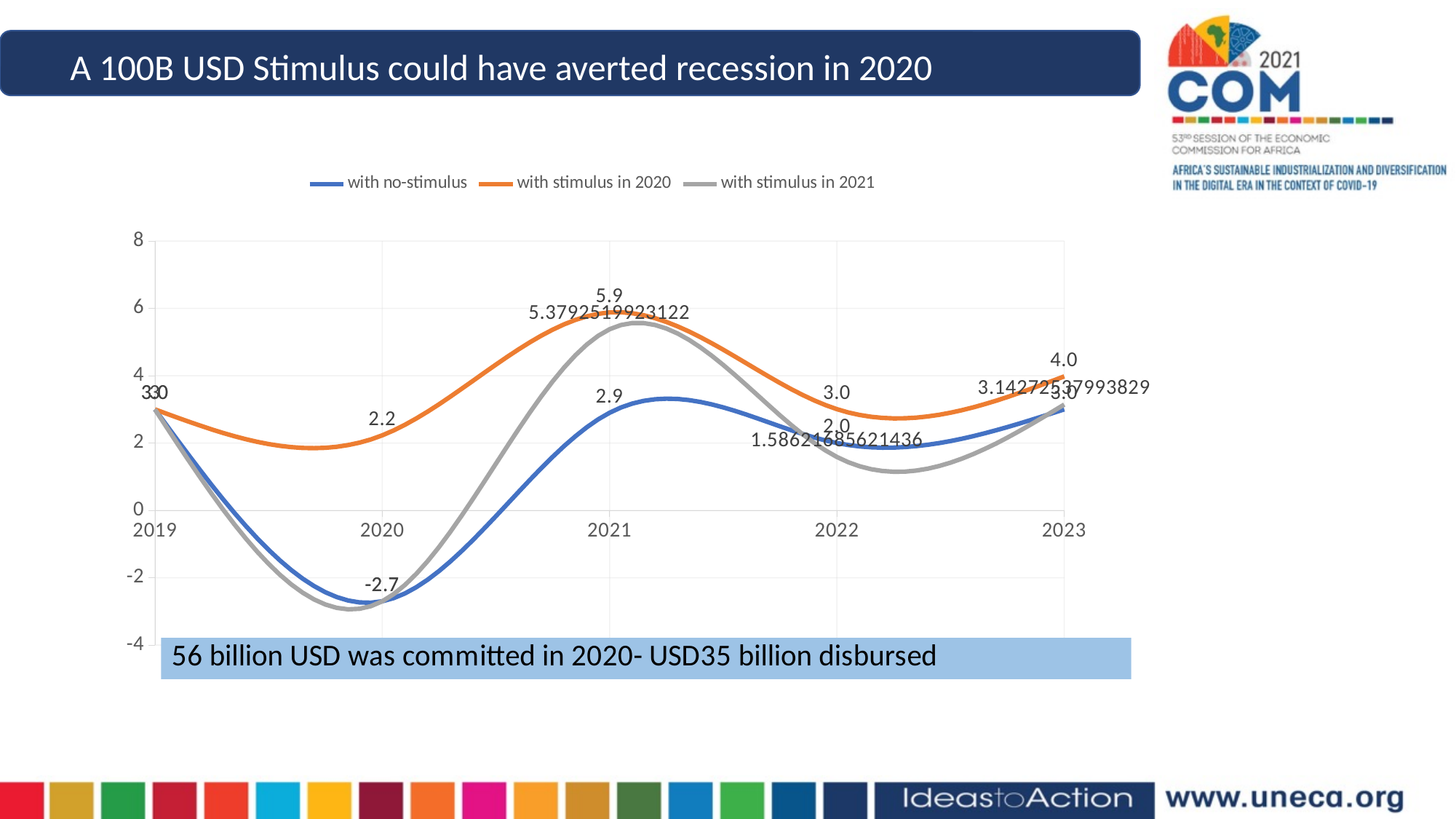
In 2022, which is larger: 'with stimulus in 2020' or 'with no-stimulus'? with stimulus in 2020 Is the value for 'with stimulus in 2021' in 2020 greater or less than 0? less What kind of chart is shown on the slide? line chart How many years are shown on the x axis? 5 What is the value for 'with no-stimulus' in 2020? -2.7 How many series does the legend list? 3 In which year does the 'with stimulus in 2020' series reach its highest value? 2021 What is the value for 'with stimulus in 2020' in 2023? 4.0 What is the value for 'with no-stimulus' in 2021? 2.9 What is the value for 'with stimulus in 2020' in 2020? 2.2 What is the value for 'with stimulus in 2020' in 2021? 5.9 What is the difference between 'with stimulus in 2020' and 'with no-stimulus' in 2021? 3.0